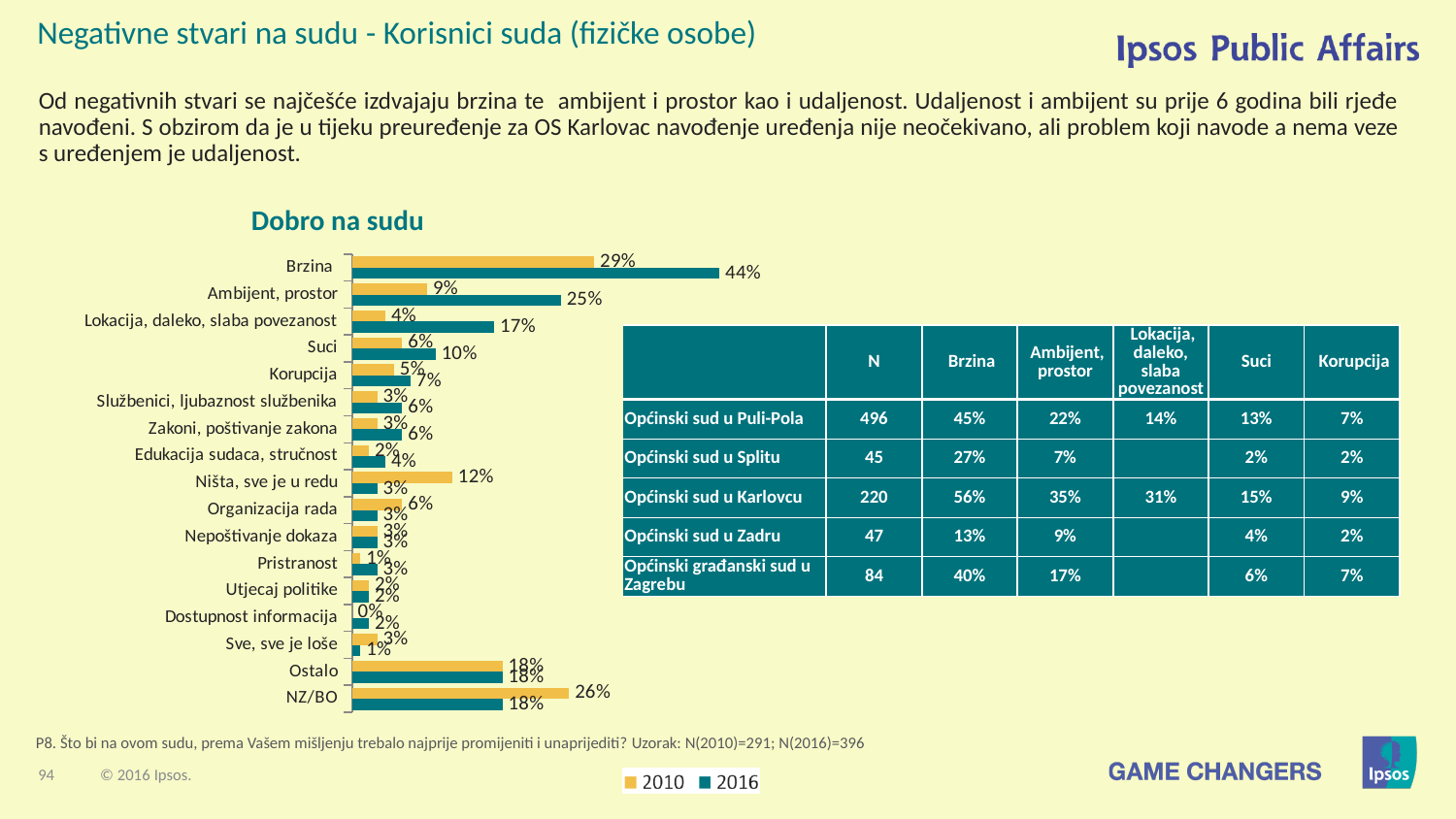
What is the 2010 value for Brzina? 29% Which is larger for Ambijent, prostor: the 2010 value or the 2016 value? 2016 What is the difference between the 2016 and 2010 values for Brzina? 15% What is the title of the chart? Dobro na sudu What is the difference between the 2016 and 2010 values for Lokacija, daleko, slaba povezanost? 13% What kind of chart is shown on the slide? Bar chart What is the 2016 value for Brzina? 44% What is the 2010 value for NZ/BO? 26% Which category has the highest 2016 value? Brzina How many series does the legend list? 2 What is the 2016 value for Ambijent, prostor? 25% What is the 2010 value for Ništa, sve je u redu? 12%